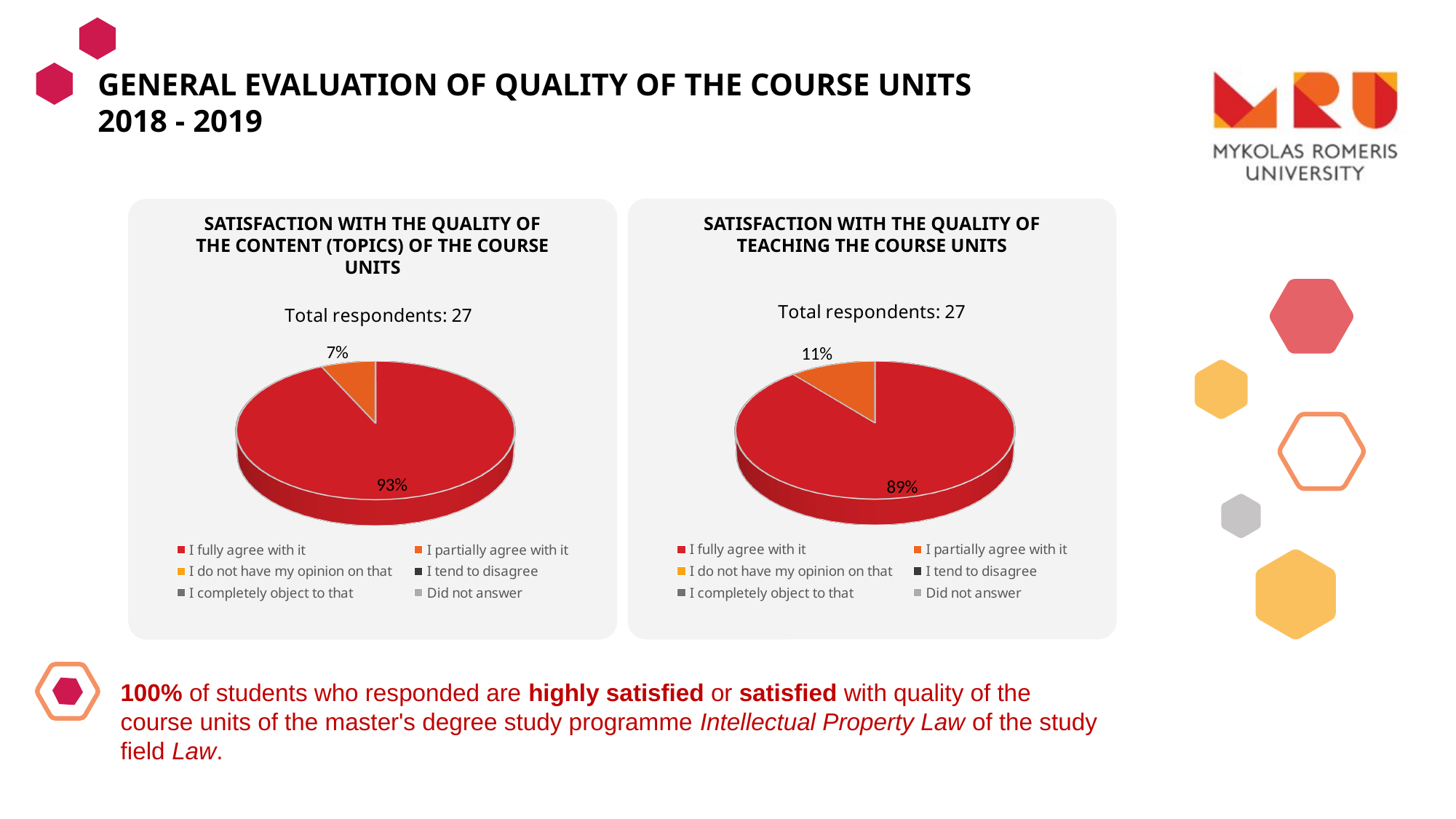
In the chart titled 'Satisfaction with the quality of teaching the course units', what share of respondents chose 'I partially agree with it'? 11% In the chart titled 'Satisfaction with the quality of teaching the course units', is the share for 'I fully agree with it' greater or less than 50%? greater In the chart titled 'Satisfaction with the quality of the content (topics) of the course units', what share of respondents chose 'I partially agree with it'? 7% In the chart titled 'Satisfaction with the quality of teaching the course units', what colour represents 'I fully agree with it'? Red In the chart titled 'Satisfaction with the quality of teaching the course units', which response category has the largest share? I fully agree with it In the chart titled 'Satisfaction with the quality of the content (topics) of the course units', what is the difference between the 'I fully agree with it' share and the 'I partially agree with it' share? 86 percentage points How many legend entries are listed for the chart titled 'Satisfaction with the quality of teaching the course units'? 6 What type of chart is used in the left-hand chart on the slide? Pie chart How many total respondents are reported for the chart titled 'Satisfaction with the quality of the content (topics) of the course units'? 27 Which chart has the larger share for 'I partially agree with it': the content (topics) chart or the teaching chart? The teaching chart In the chart titled 'Satisfaction with the quality of the content (topics) of the course units', what share of respondents chose 'I fully agree with it'? 93% In the chart titled 'Satisfaction with the quality of teaching the course units', what share of respondents chose 'I fully agree with it'? 89%